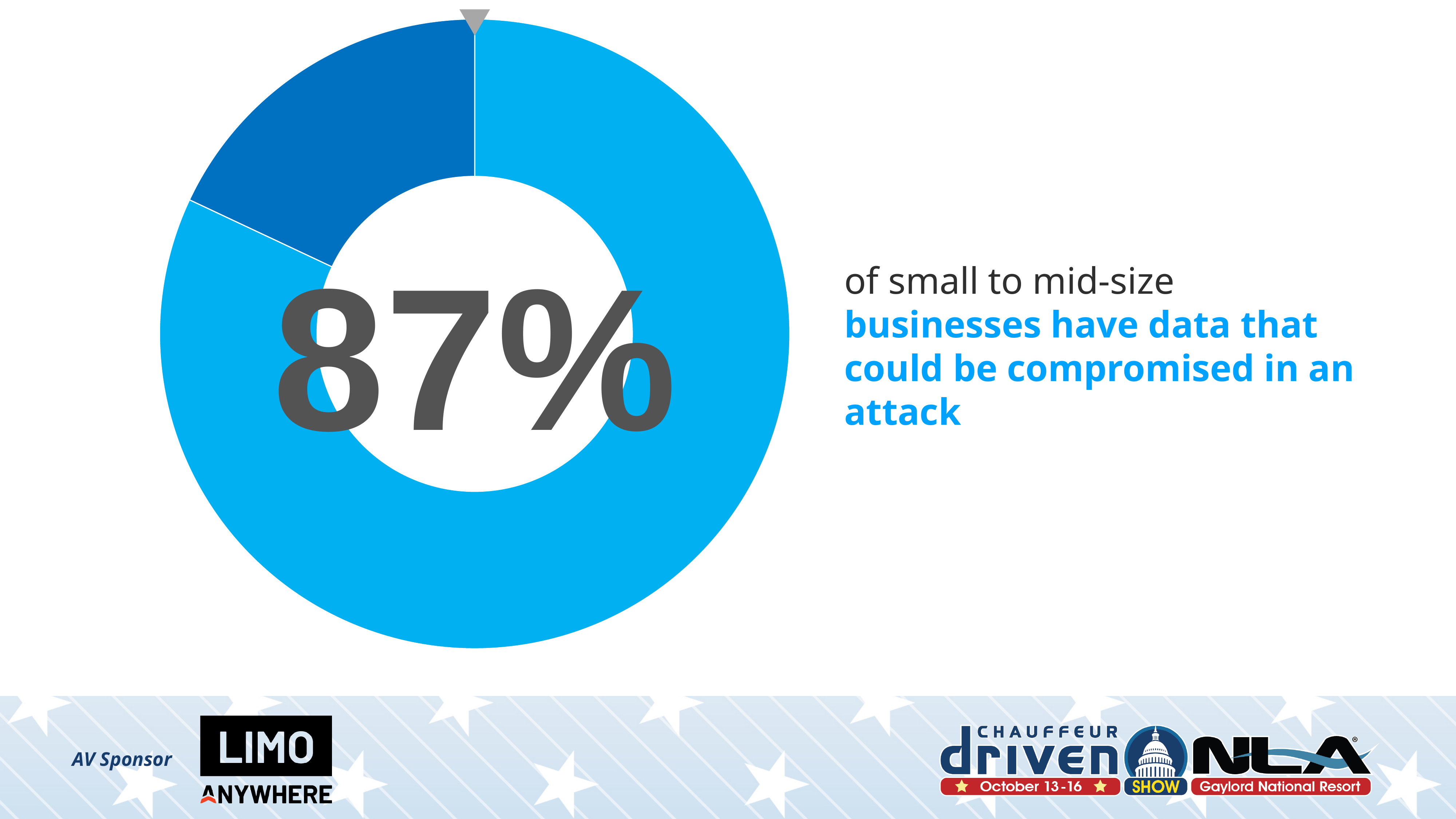
According to the slide, what does the 87% figure represent? small to mid-size businesses that have data that could be compromised in an attack Is the share of the light blue slice greater or less than 50%? greater How many slices does the donut chart have? 2 What kind of chart is shown on the slide? donut chart Is the share of the dark blue slice greater or less than 50%? less What percentage is printed in the centre of the donut chart? 87% Which slice of the donut chart is larger, the light blue one or the dark blue one? light blue What colour is the larger slice of the donut chart? light blue Which slice of the donut chart is the smallest? the dark blue slice